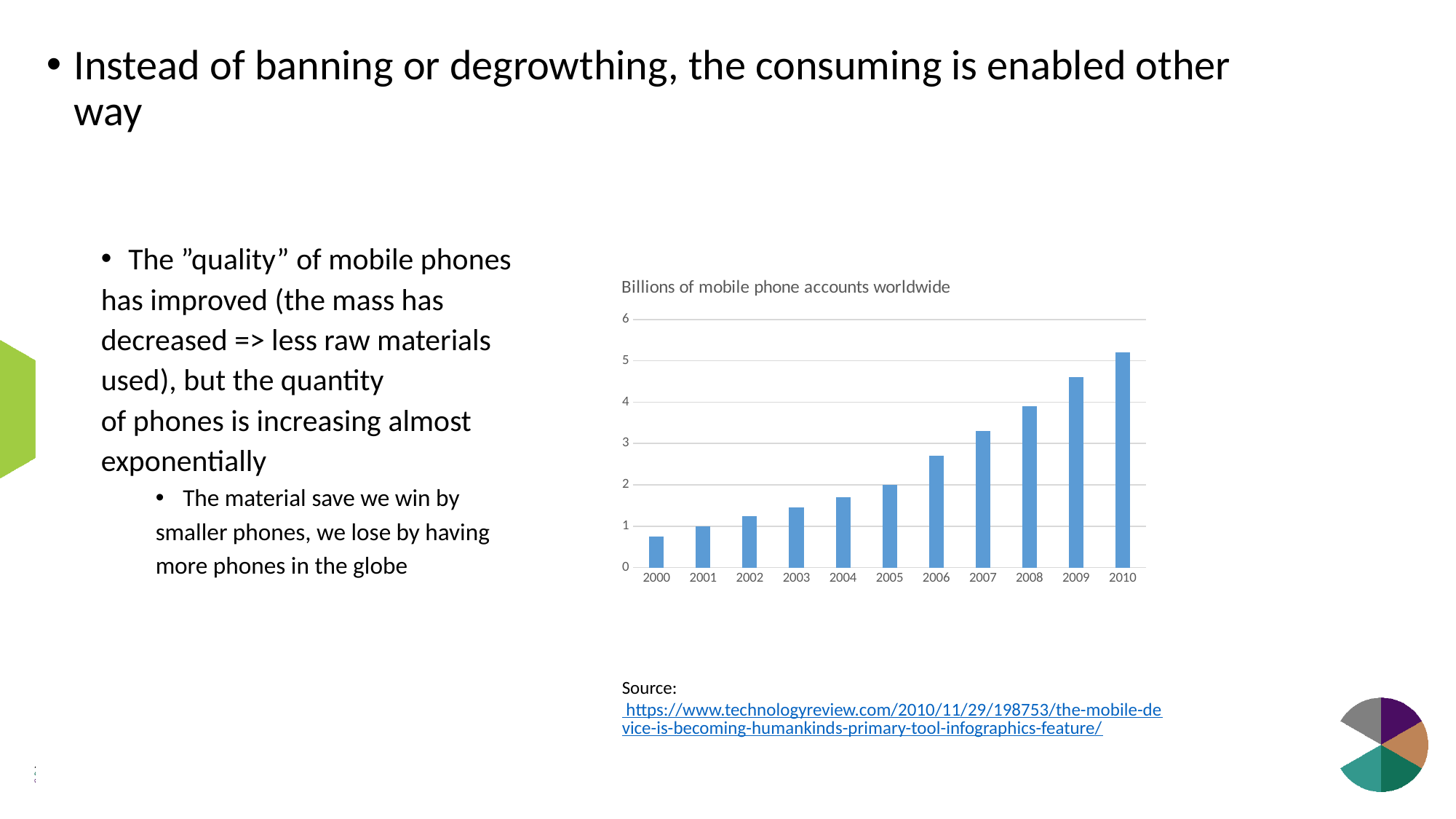
Do the values rise or fall from 2000 to 2010? rise Is the value for 2010 greater or less than 5? greater Which is larger, the value for 2006 or the value for 2009? 2009 Which year has the lowest value in the chart? 2000 Which year has the highest value in the chart? 2010 Is the value for 2007 greater or less than 3? greater What is the title of the chart? Billions of mobile phone accounts worldwide What kind of chart is shown on the slide? bar chart How many years are shown on the x axis of the chart? 11 What is the first year shown on the x axis of the chart? 2000 Is the value for 2008 greater or less than 4? less